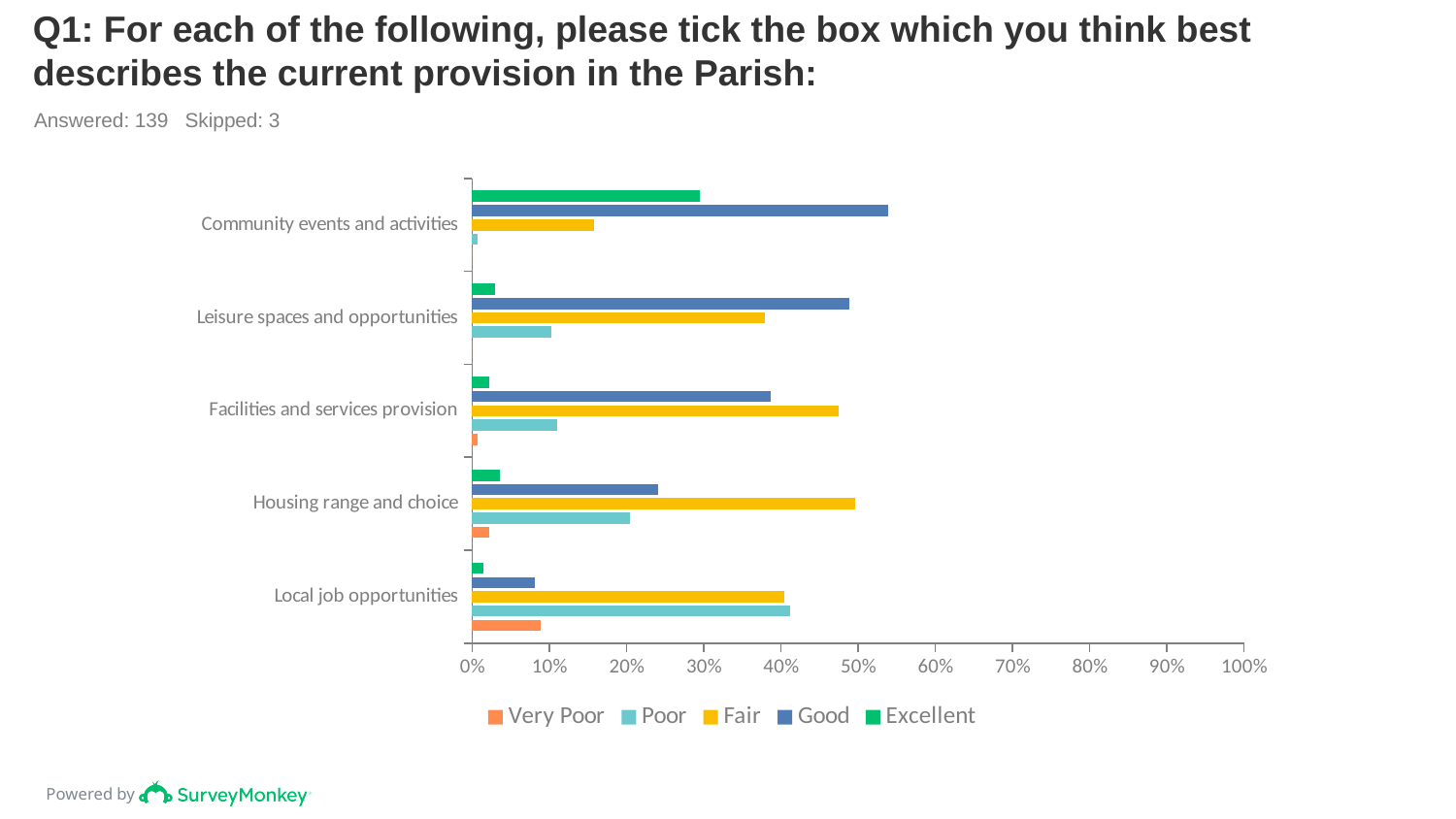
What kind of chart is shown on the slide? bar chart Which category has the highest Excellent value? Community events and activities Is the Fair value for Leisure spaces and opportunities greater or less than 30%? greater How many series does the legend list? 5 How many categories are plotted on the chart? 5 Which category has the highest Very Poor value? Local job opportunities Is the Good value for Community events and activities greater or less than 50%? greater Is the Good value for Local job opportunities greater or less than 10%? less For Facilities and services provision, which is larger: the Good value or the Fair value? Fair Which category has the highest Good value? Community events and activities What colour represents the Excellent series in the legend? green